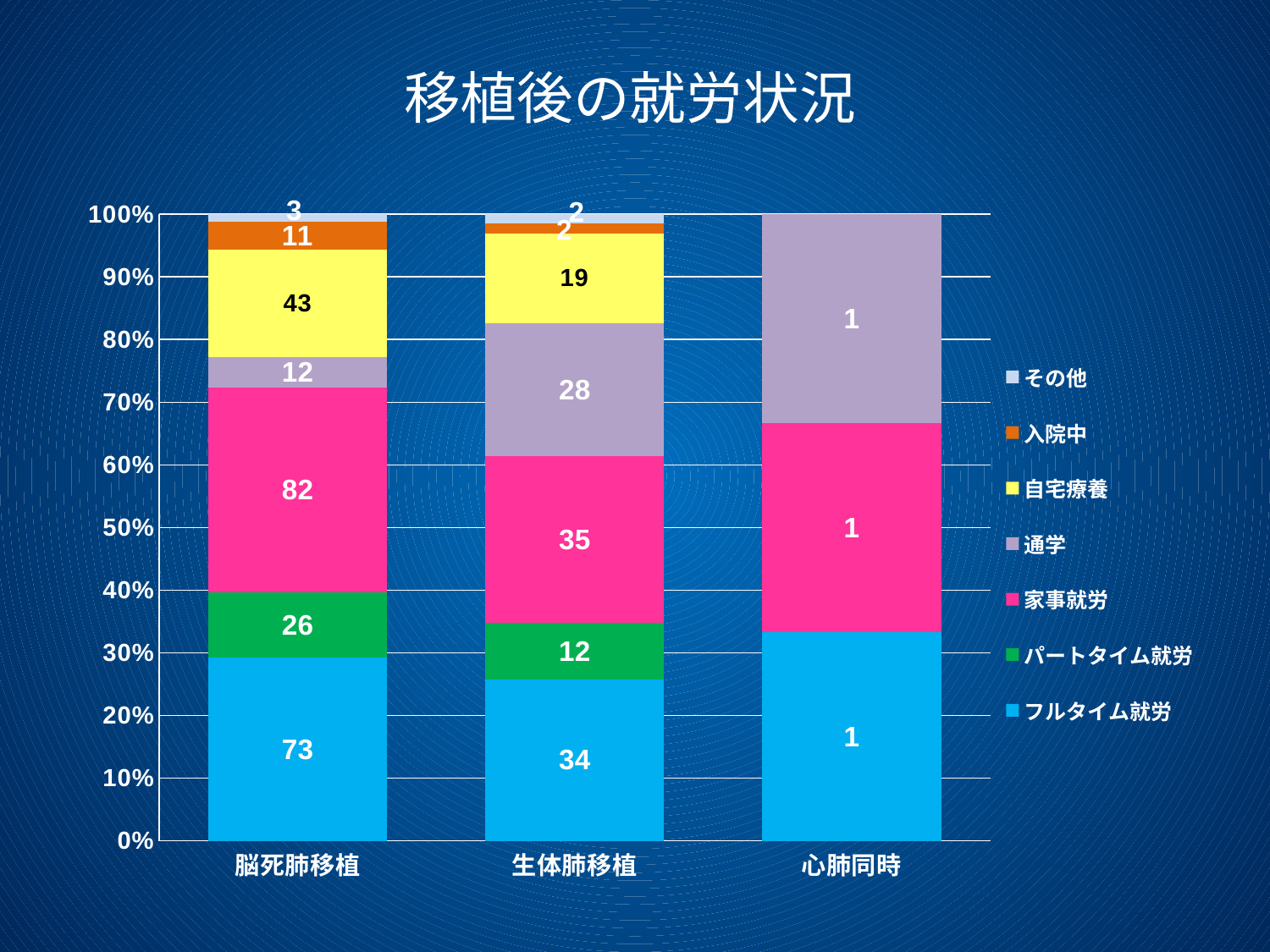
What is the value for 通学 in the 生体肺移植 bar? 28 How many categories are shown on the x axis? 3 What is the value for フルタイム就労 in the 脳死肺移植 bar? 73 Which segment has the smallest value in the 脳死肺移植 bar? その他 How many series does the legend list? 7 What is the value for 入院中 in the 脳死肺移植 bar? 11 What type of chart is shown on the slide? stacked bar chart Which segment has the largest value in the 脳死肺移植 bar? 家事就労 What is the difference between the 自宅療養 values for 脳死肺移植 and 生体肺移植? 24 Which is larger: パートタイム就労 for 脳死肺移植 or パートタイム就労 for 生体肺移植? 脳死肺移植 What is the value for 家事就労 in the 生体肺移植 bar? 35 What is the sum of all the labelled values in the 生体肺移植 bar? 132